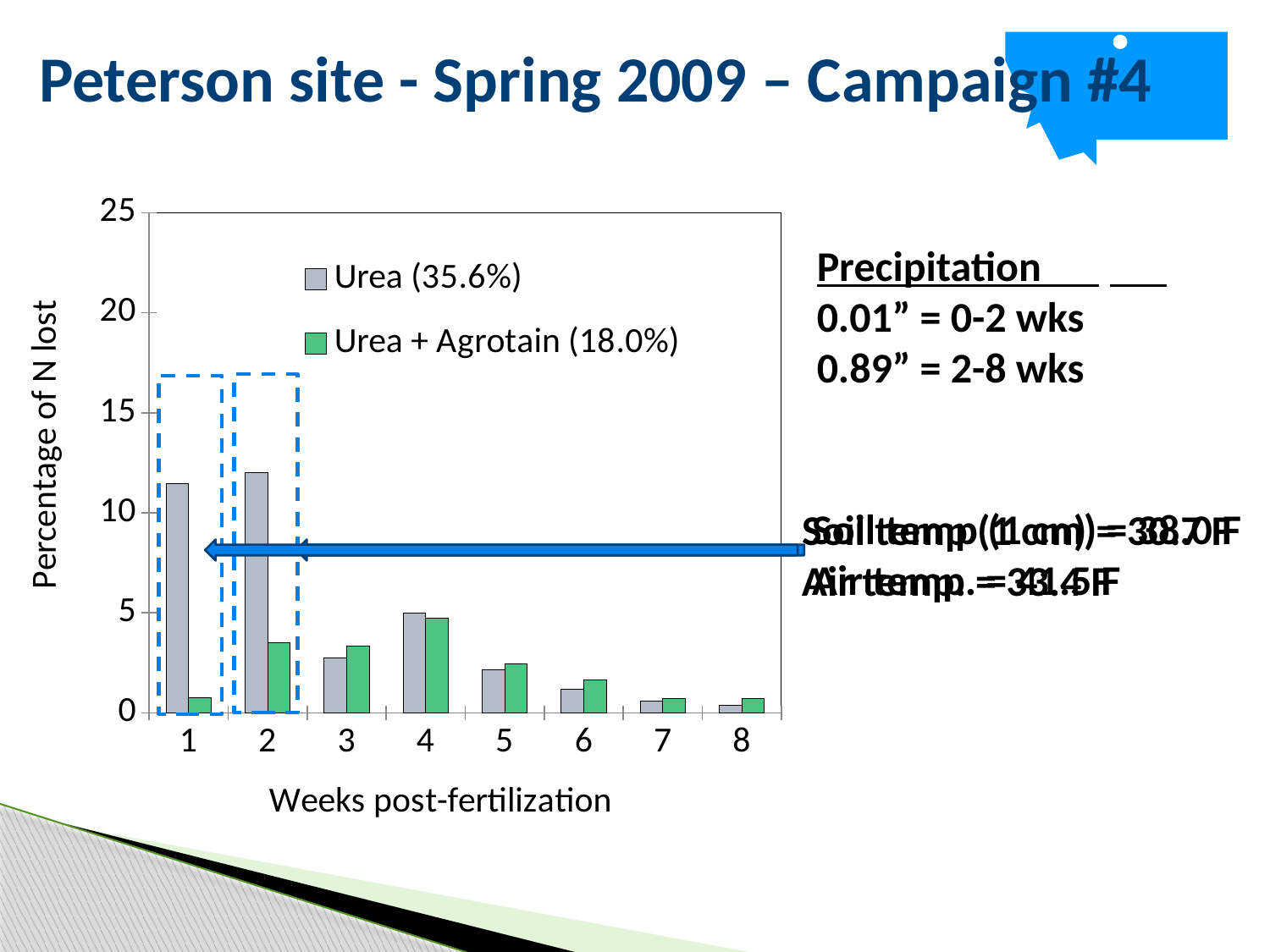
How many weeks post-fertilization are shown on the x axis? 8 Is the value for Urea + Agrotain at week 1 greater or less than 5? less At week 1, which series has the larger value, Urea or Urea + Agrotain? Urea What are the two series named in the chart legend? Urea (35.6%) and Urea + Agrotain (18.0%) Is the value for Urea at week 2 greater or less than 10? greater How many series does the chart legend list? 2 Do the values for Urea rise or fall from week 4 to week 8? fall At week 2, which series has the larger value, Urea or Urea + Agrotain? Urea Is the value for Urea at week 1 greater or less than 10? greater What kind of chart is shown on the slide? bar chart In which week is the value for Urea + Agrotain highest? 4 What is the title of the y axis? Percentage of N lost